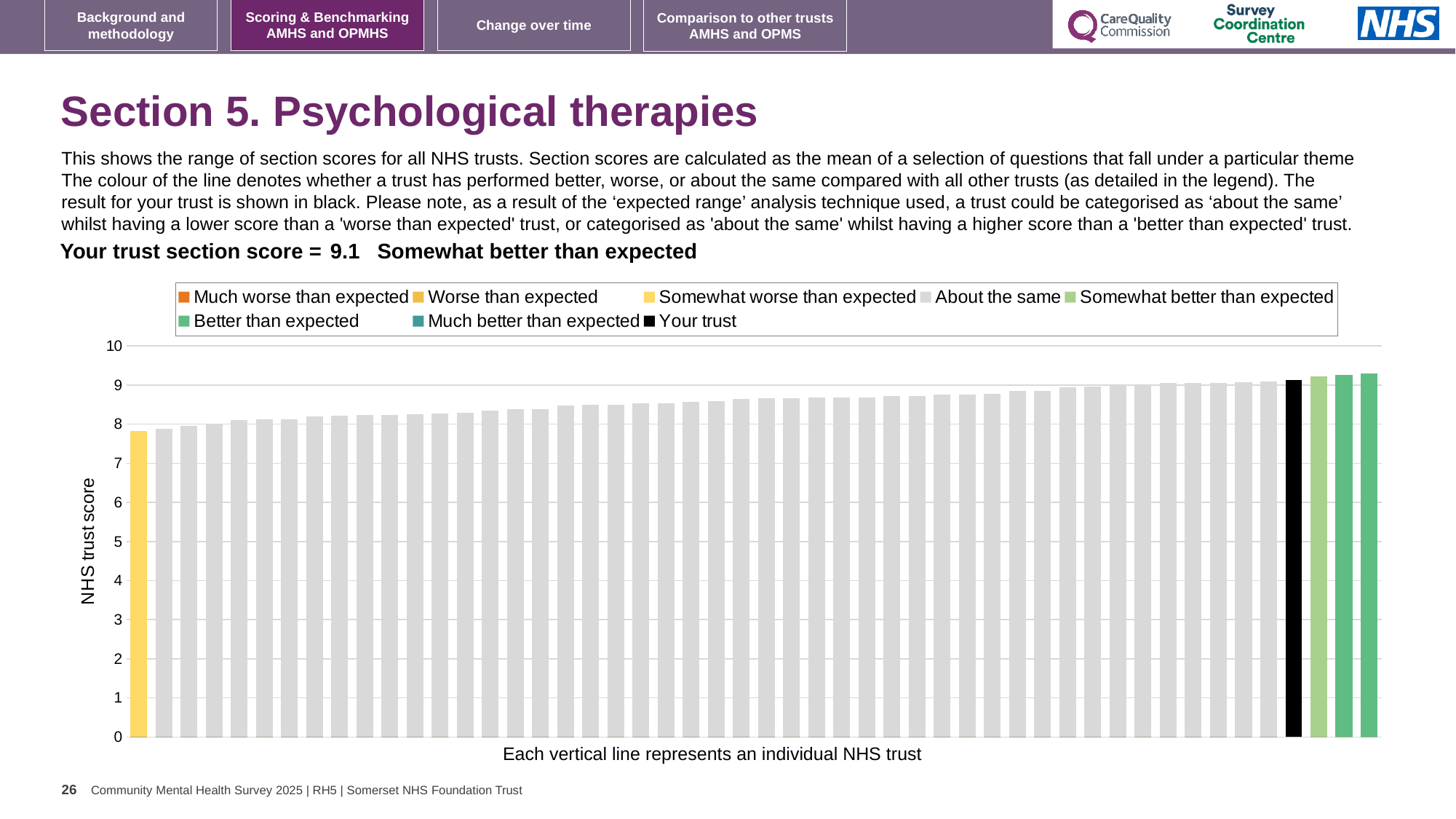
Which bar is higher: the black 'Your trust' bar or the leftmost yellow bar? the black 'Your trust' bar What colour is used for the 'Your trust' bar in the legend? black Is the value of the leftmost (yellow) bar greater or less than 8? less How many entries does the chart legend list? 8 What is the title of the y axis? NHS trust score What kind of chart is shown on the slide? bar chart Is the value of the rightmost bar greater or less than 9? greater Is the value of the leftmost bar greater or less than 5? greater What is the section score for your trust shown on the slide? 9.1 How is your trust's score categorised compared with other trusts? Somewhat better than expected What is the highest value shown on the y axis? 10 Do the bar values rise or fall from left to right along the x axis? rise